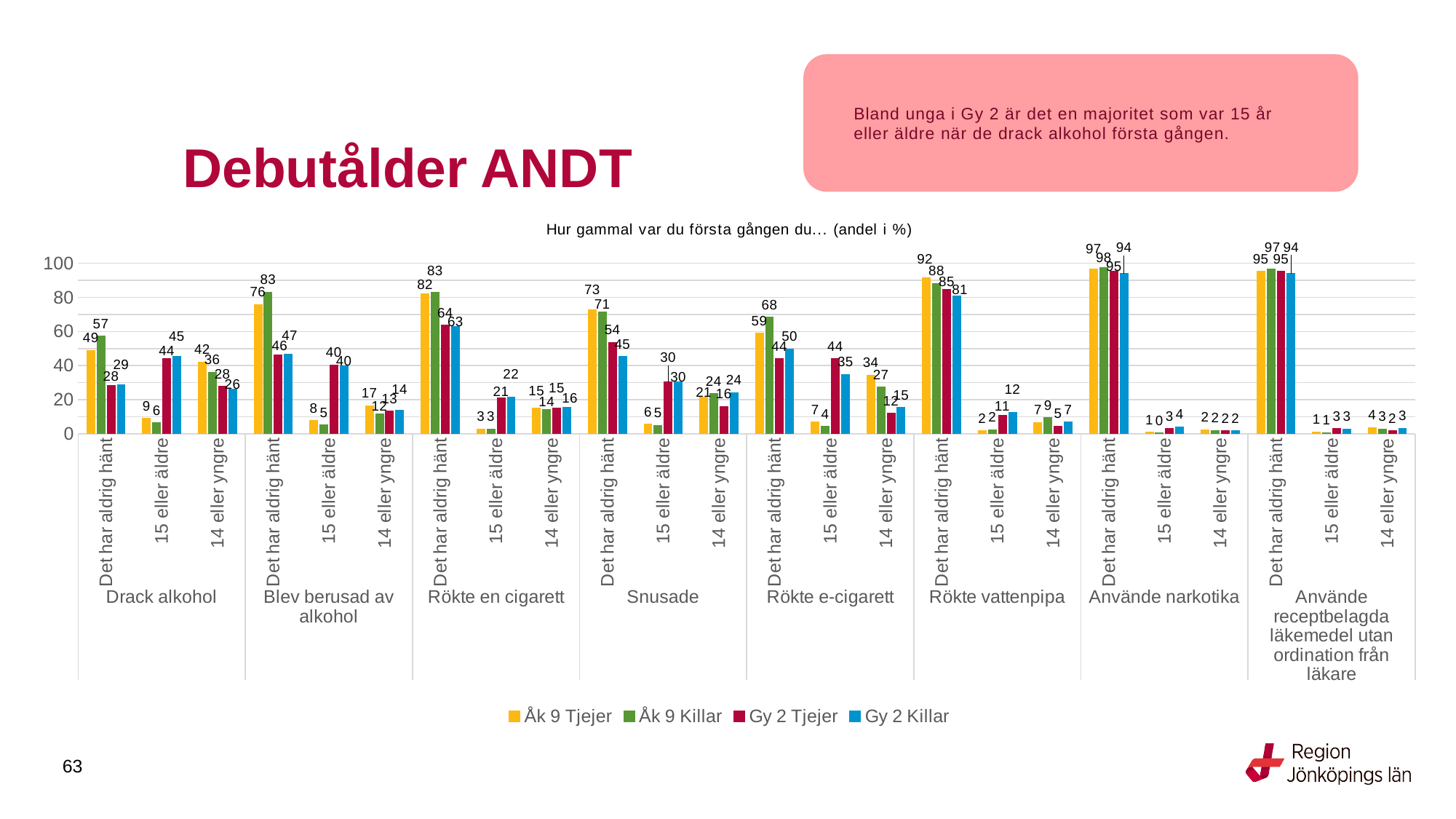
Is the value for Gy 2 Tjejer for 'Det har aldrig hänt' under 'Rökte vattenpipa' greater or less than 80? greater What is the value for Gy 2 Killar for '15 eller äldre' under 'Rökte e-cigarett'? 35 Which series has the highest value for 'Det har aldrig hänt' under 'Använde narkotika'? Åk 9 Killar What type of chart is shown on the slide? Bar chart How many behaviour groups are shown along the x axis? 8 What is the title of the chart? Hur gammal var du första gången du… (andel i %) What is the value for Åk 9 Killar for 'Det har aldrig hänt' under 'Blev berusad av alkohol'? 83 How many series does the legend list? 4 Which series has the lowest value for 'Det har aldrig hänt' under 'Snusade'? Gy 2 Killar What is the value for Gy 2 Tjejer for '15 eller äldre' under 'Drack alkohol'? 44 What is the difference between Åk 9 Tjejer and Gy 2 Tjejer for 'Det har aldrig hänt' under 'Rökte en cigarett'? 18 Which is larger for '14 eller yngre' under 'Rökte e-cigarett': Åk 9 Tjejer or Åk 9 Killar? Åk 9 Tjejer